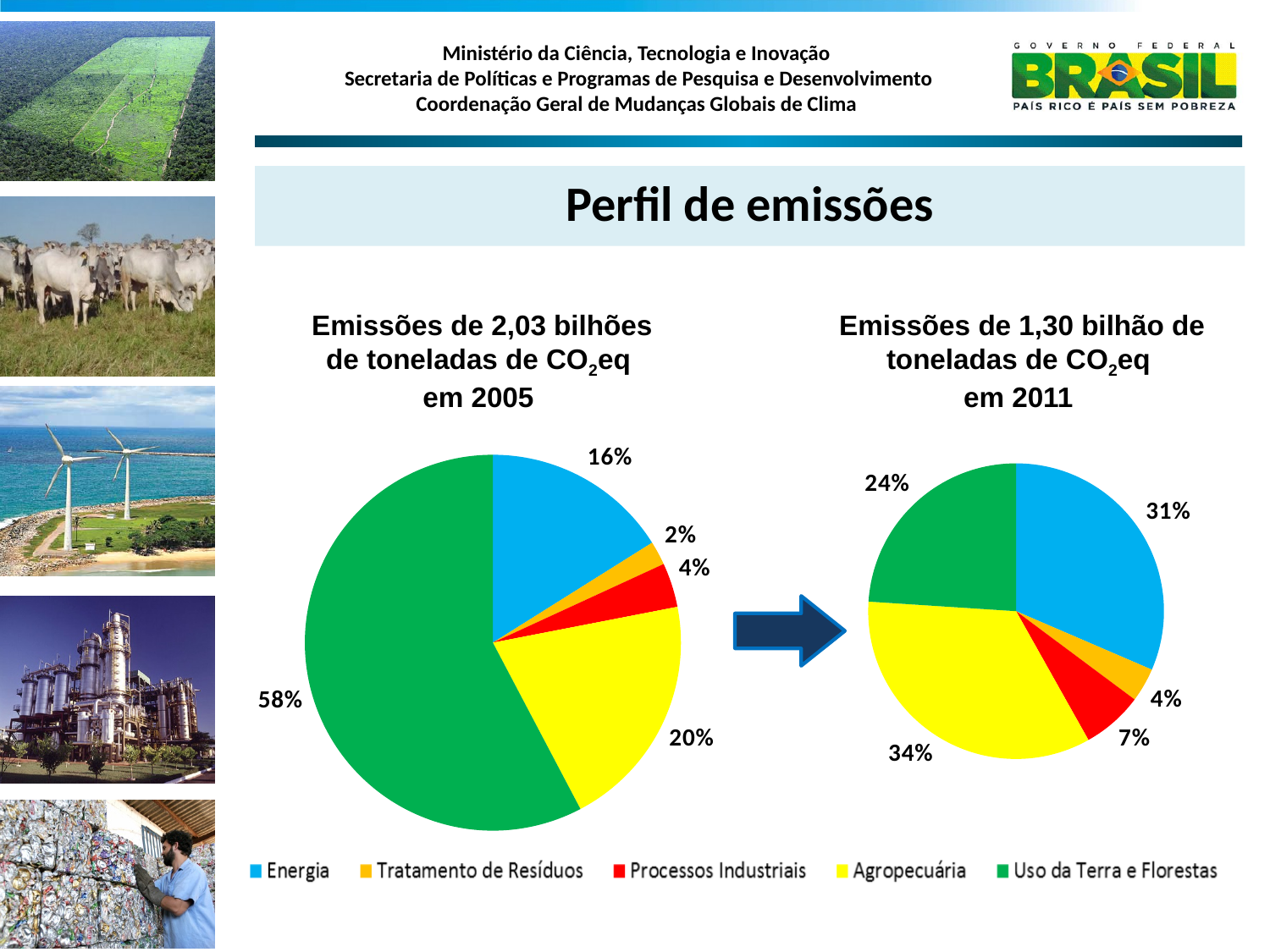
How many categories does the legend list for the pie charts? 5 In the 2011 pie chart, which is larger: Processos Industriais or Tratamento de Resíduos? Processos Industriais In the 2005 pie chart, which category has the largest share? Uso da Terra e Florestas What is the difference between the Energia share in 2011 and the Energia share in 2005? 15 percentage points In the 2005 pie chart, which category has the smallest share? Tratamento de Resíduos In the 2011 pie chart, which category has the largest share? Agropecuária In the 2011 pie chart, what share of emissions comes from Agropecuária? 34% In the 2005 pie chart, what is the share for Energia? 16% What type of chart is used to show the emissions profile for 2005 and 2011? Pie chart Which colour represents Agropecuária in the pie charts? Yellow In the 2011 pie chart, what is the share for Energia? 31% In the 2005 pie chart, what share of emissions comes from Uso da Terra e Florestas? 58%